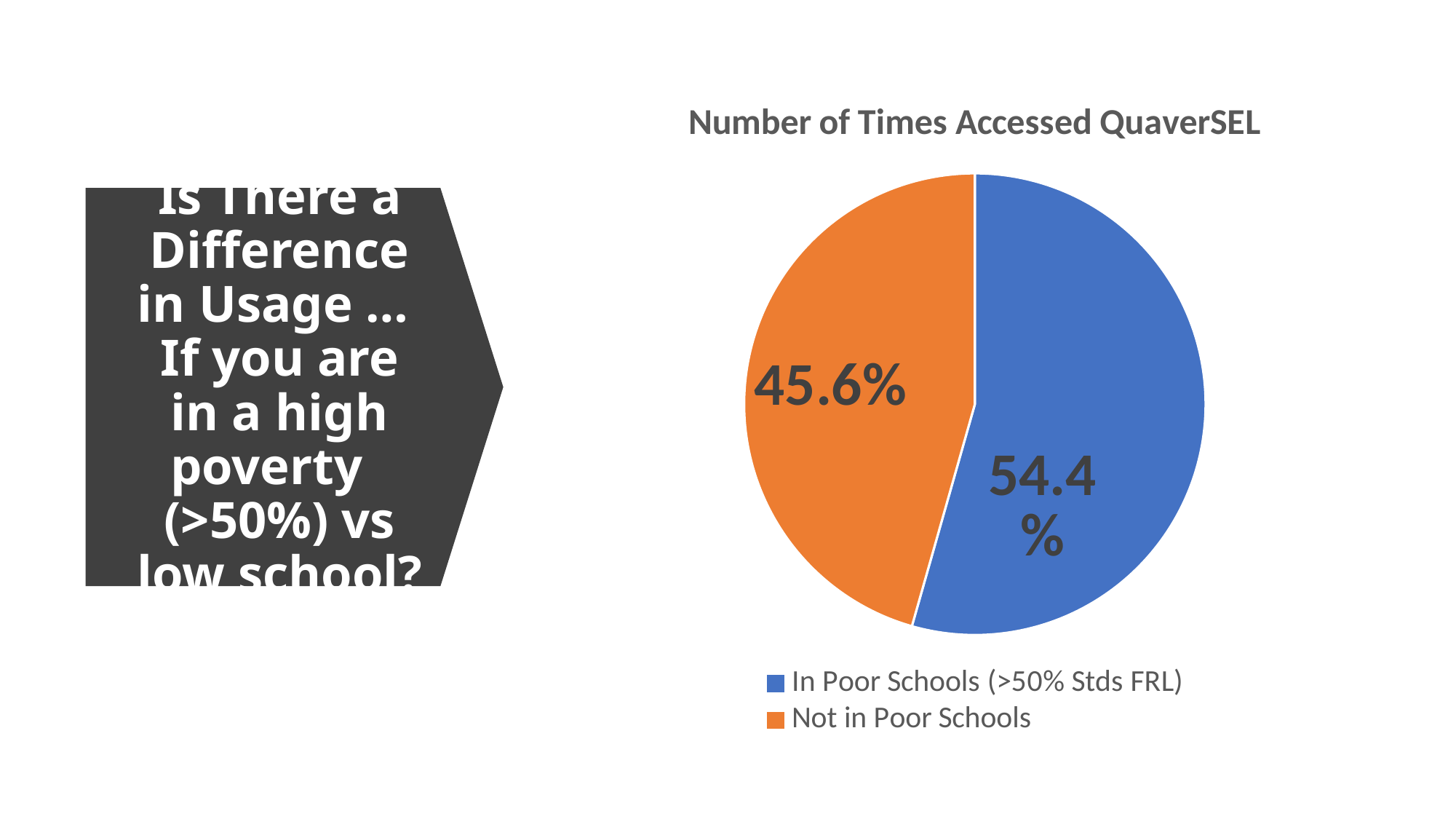
How many slices does the pie chart have? 2 Which category has the largest slice of the pie? In Poor Schools (>50% Stds FRL) Which category has the smallest slice of the pie? Not in Poor Schools What colour is the slice for Not in Poor Schools? orange How many entries does the legend list? 2 What is the title of the chart? Number of Times Accessed QuaverSEL Which slice is larger, In Poor Schools (>50% Stds FRL) or Not in Poor Schools? In Poor Schools (>50% Stds FRL) Is the share for In Poor Schools (>50% Stds FRL) greater or less than 50%? greater What type of chart is shown on the slide? pie chart What share of the pie is labelled for Not in Poor Schools? 45.6% What share of the pie is labelled for In Poor Schools (>50% Stds FRL)? 54.4% What is the difference in percentage points between the In Poor Schools slice and the Not in Poor Schools slice? 8.8